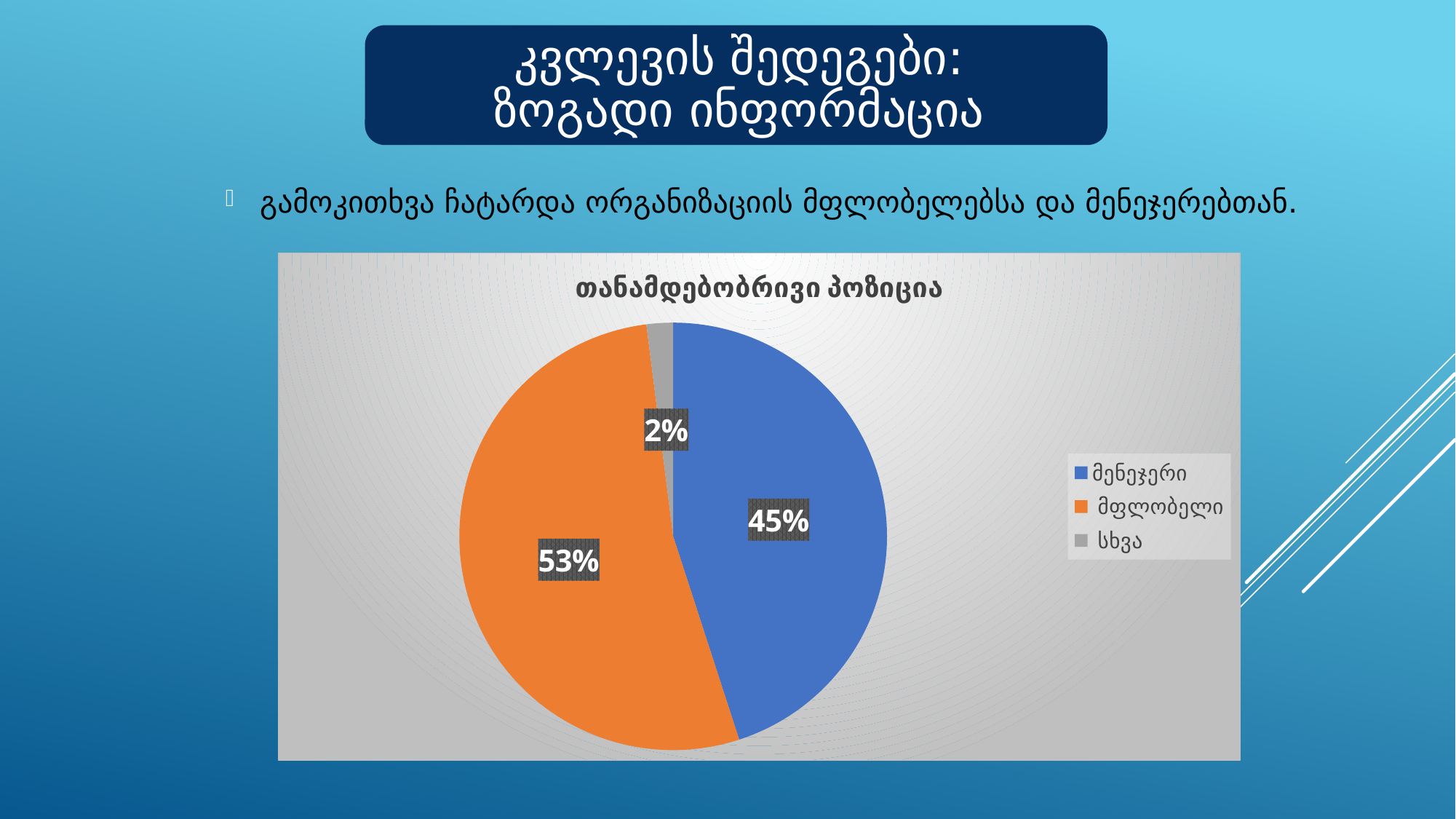
What share of the pie does მენეჯერი have? 45% How many entries does the legend list? 3 Which category has the smallest slice of the pie? სხვა Which category has the largest slice of the pie? მფლობელი What colour is the slice for მენეჯერი? blue Which is larger, the share for მენეჯერი or the share for მფლობელი? მფლობელი What is the title of the chart? თანამდებობრივი პოზიცია How many categories does the pie chart show? 3 What is the difference in percentage points between მფლობელი and მენეჯერი? 8 What share of the pie does მფლობელი have? 53% What kind of chart is shown on the slide? pie chart What share of the pie does სხვა have? 2%